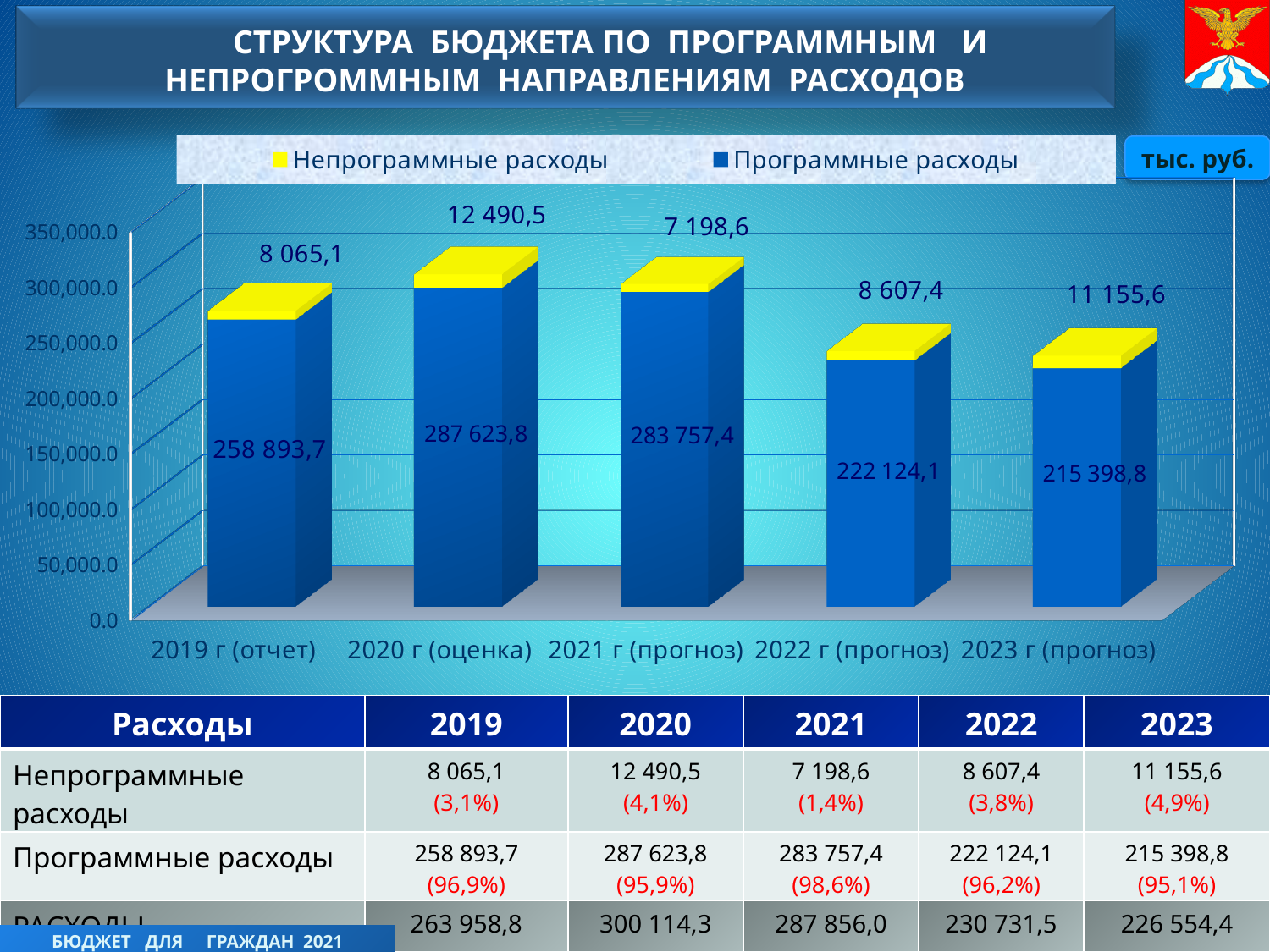
In which year is the value of Непрограммные расходы the lowest? 2021 г (прогноз) How many year categories are plotted on the x axis of the chart? 5 What is the value of Программные расходы for 2020 г (оценка)? 287 623,8 What kind of chart is shown on the slide? Stacked bar chart What is the difference between Непрограммные расходы in 2020 г (оценка) and in 2019 г (отчет)? 4 425,4 Which is larger: Программные расходы in 2019 г (отчет) or in 2022 г (прогноз)? 2019 г (отчет) What is the value of Непрограммные расходы for 2021 г (прогноз)? 7 198,6 What is the total of the stacked bar for 2021 г (прогноз)? 290 956,0 In which year is the value of Программные расходы the highest? 2020 г (оценка) What is the value of Непрограммные расходы for 2023 г (прогноз)? 11 155,6 How many series does the chart legend list? 2 What unit is indicated in the box at the top right of the chart? тыс. руб.